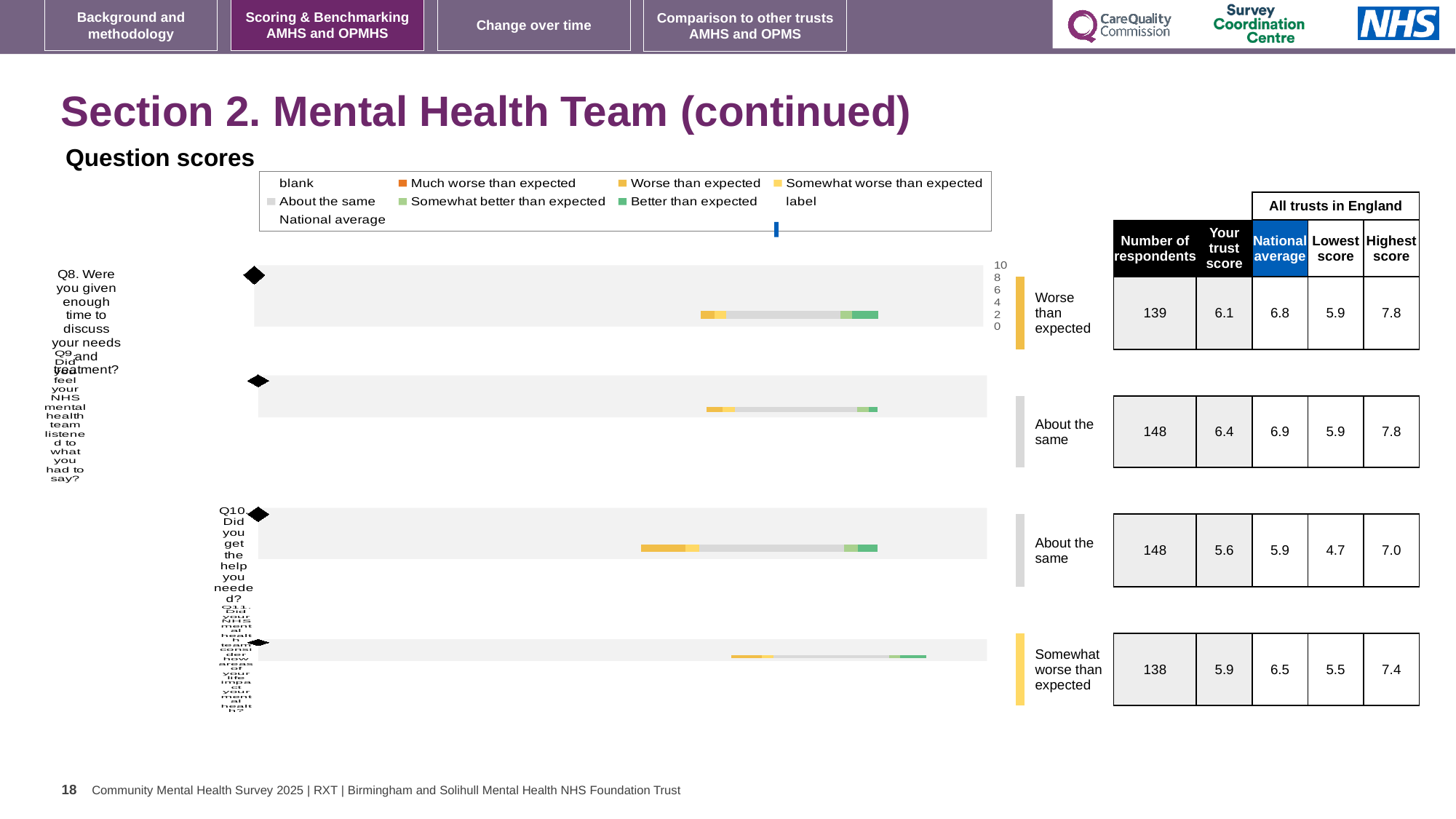
What is the trust score for Q8 (Were you given enough time to discuss your needs and treatment)? 6.1 Which question has the lowest trust score on this slide? Q10 In the legend, what colour represents 'Better than expected'? green How many questions (Q8 to Q11) have a bar chart on this slide? 4 What category label is shown for Q11's result compared to expected? Somewhat worse than expected What is the highest score across all trusts in England for Q9? 7.8 What is the national average for Q10 (Did you get the help you needed)? 5.9 How many respondents answered Q11? 138 Which question has the highest trust score on this slide? Q9 Which is larger, the trust score for Q9 or the trust score for Q10? Q9 What kind of chart is used to show the question scores on this slide? bar chart What is the difference between the national average and the trust score for Q8? 0.7